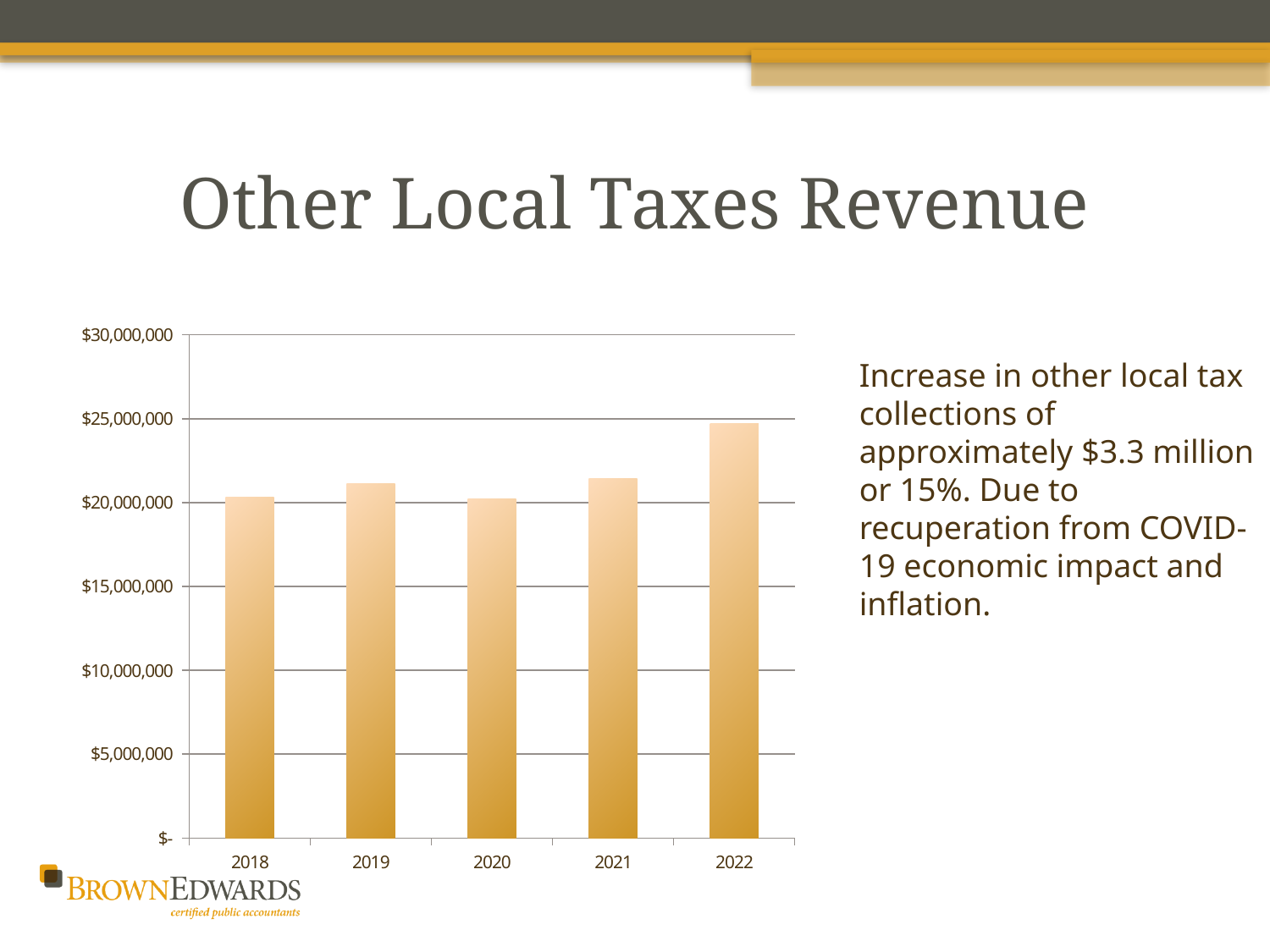
Is the value for 2019 greater or less than $25,000,000? less Is the value for 2022 greater or less than $20,000,000? greater What is the title of the slide containing the chart? Other Local Taxes Revenue Is the value for 2020 greater or less than $15,000,000? greater Which is larger, the value for 2021 or the value for 2022? 2022 What is the highest value shown on the chart's y axis? $30,000,000 Which year has the highest other local taxes revenue? 2022 How many years are shown on the x axis of the chart? 5 Does the revenue rise or fall from 2021 to 2022? rise What kind of chart is shown on the slide? bar chart Which is larger, the value for 2019 or the value for 2020? 2019